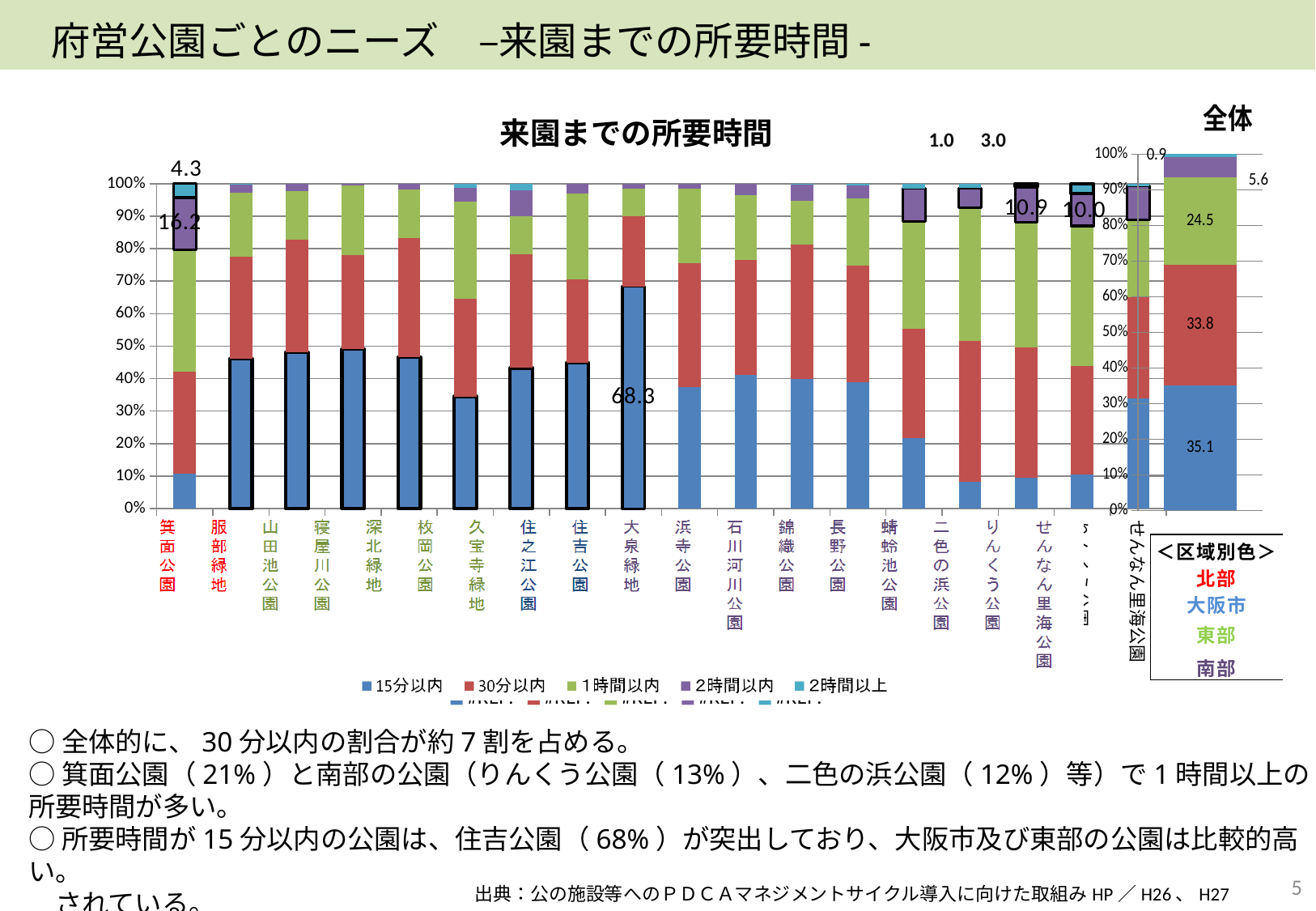
What kind of chart is the main chart 来園までの所要時間? Stacked bar chart In the 全体 chart on the right, which segment has the smallest value? 2時間以上 In the main chart 来園までの所要時間, what is the labelled value of the 2時間以上 segment for 箕面公園? 4.3 How many series does the legend of the main chart 来園までの所要時間 list? 5 In the 全体 chart on the right, which segment has the largest value? 15分以内 In the 全体 chart on the right, what is the value for 30分以内? 33.8 In the 全体 chart on the right, what is the difference between the 30分以内 value and the 1時間以内 value? 9.3 In the main chart 来園までの所要時間, is the 15分以内 value for 箕面公園 greater or less than 20%? less In the main chart 来園までの所要時間, what is the labelled value of the 2時間以内 segment for 箕面公園? 16.2 In the 全体 chart on the right, what is the value for 1時間以内? 24.5 In the 全体 chart on the right, what is the value for 2時間以内? 5.6 In the 全体 chart on the right, what is the value for 15分以内? 35.1